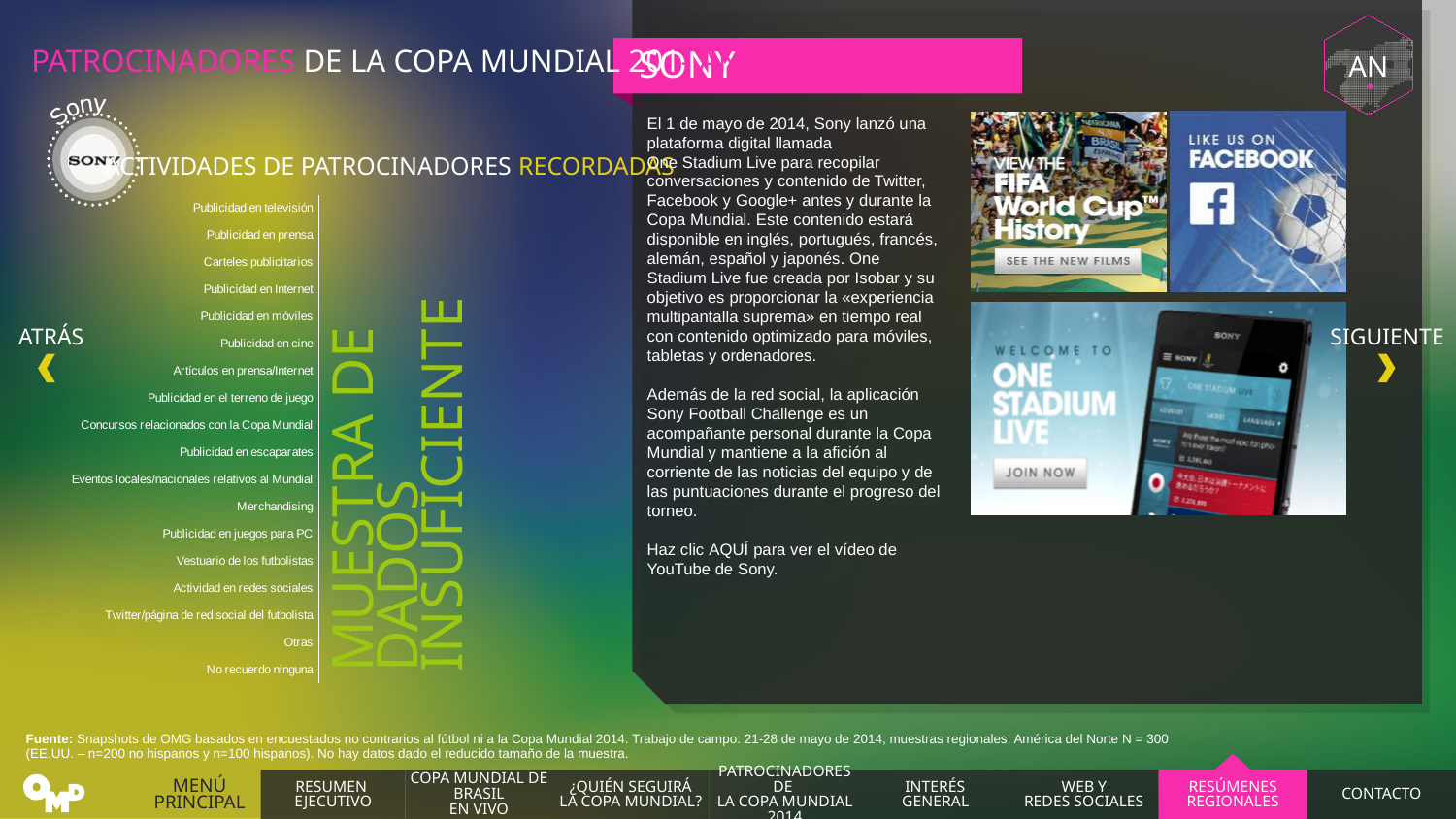
What is the title of the chart on the slide? ACTIVIDADES DE PATROCINADORES RECORDADAS How many categories are listed on the chart's axis? 18 What is the last category listed at the bottom of the chart's axis? No recuerdo ninguna What is the first category listed at the top of the chart's axis? Publicidad en televisión What message is displayed in place of the plotted data on the chart? MUESTRA DE DADOS INSUFICIENTE